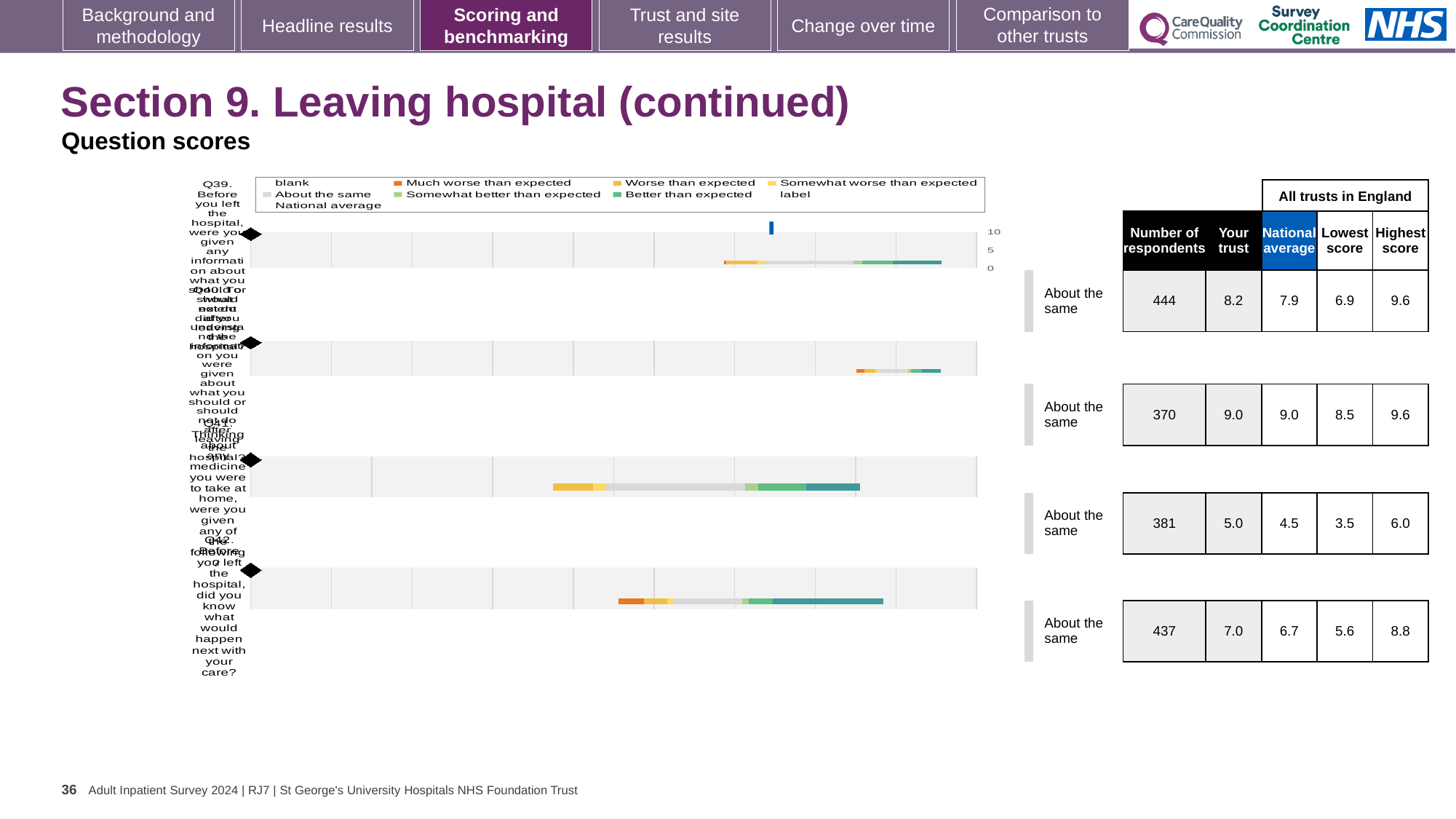
In the table beside the chart, what is the number of respondents for the first row (Q39)? 444 In the table beside the chart, which row has the highest number of respondents? the first row (444) In the table beside the chart, what is the highest score for the third row? 6.0 What benchmark label is shown next to each of the four chart rows? About the same What kind of chart is shown on the slide? bar chart In the table beside the chart, which row has the lowest 'Your trust' score? the third row (5.0) How many question rows (bars) does the chart show? 4 In the table beside the chart, what is the difference between the 'Your trust' score and the national average for the third row? 0.5 In the table beside the chart, what is the lowest score for the fourth row? 5.6 In the table beside the chart, what is the national average for the first row (Q39)? 7.9 In the table beside the chart, what is the 'Your trust' score for the first row (Q39)? 8.2 In the table beside the chart, which is larger for the third row: the 'Your trust' score or the national average? Your trust